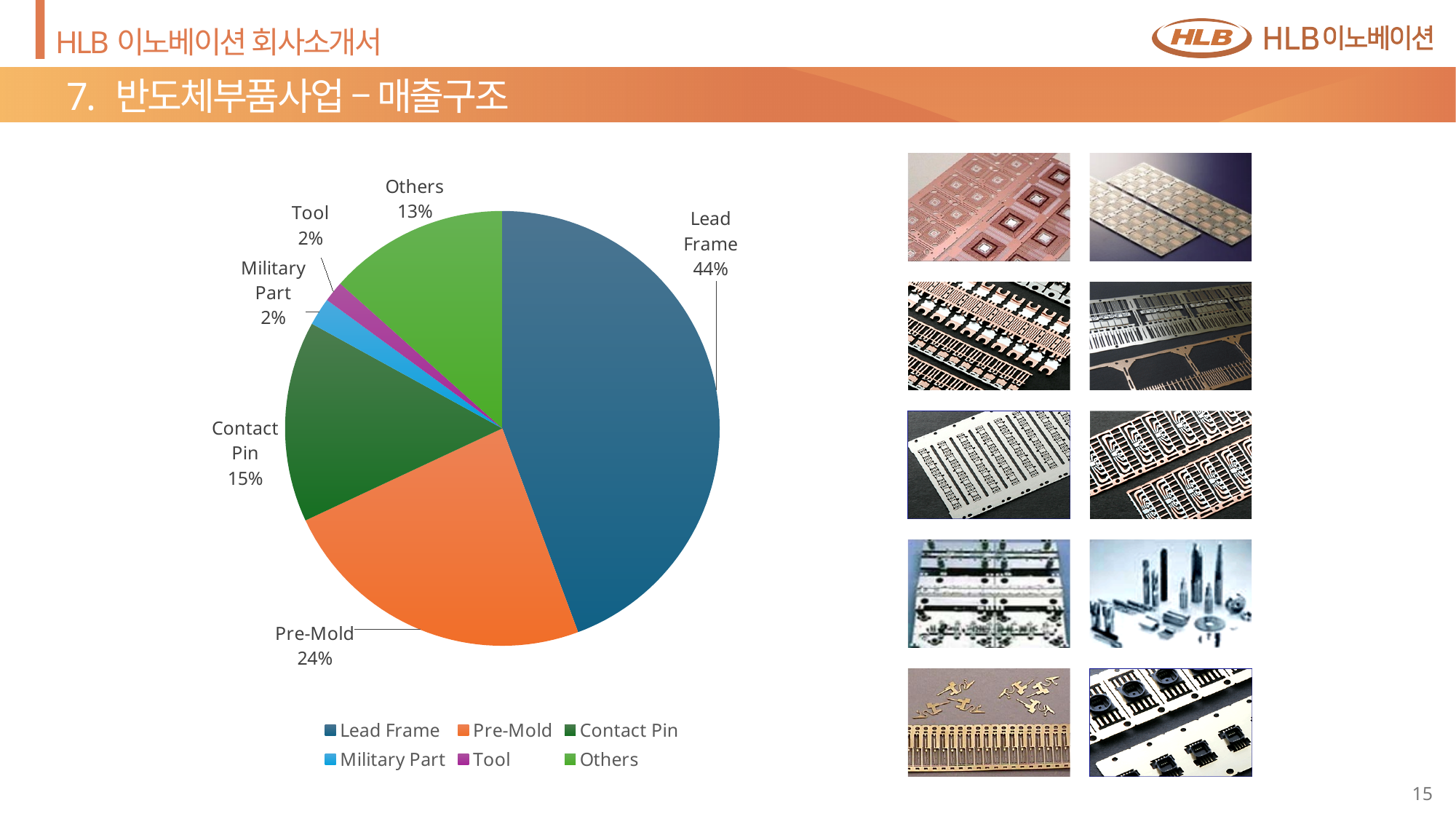
Which category has the largest share of the pie? Lead Frame What share of the pie does Lead Frame account for? 44% What kind of chart is shown on the slide? Pie chart Which is larger, Others or Tool? Others How many categories does the pie chart show? 6 What percentage is shown for Pre-Mold? 24% What colour is the Others slice in the pie chart? Green What is the difference in percentage points between Lead Frame and Pre-Mold? 20 What is the difference between Contact Pin and Others? 2 What percentage is shown for Others? 13% Which is larger, Pre-Mold or Contact Pin? Pre-Mold What is the value for Contact Pin? 15%